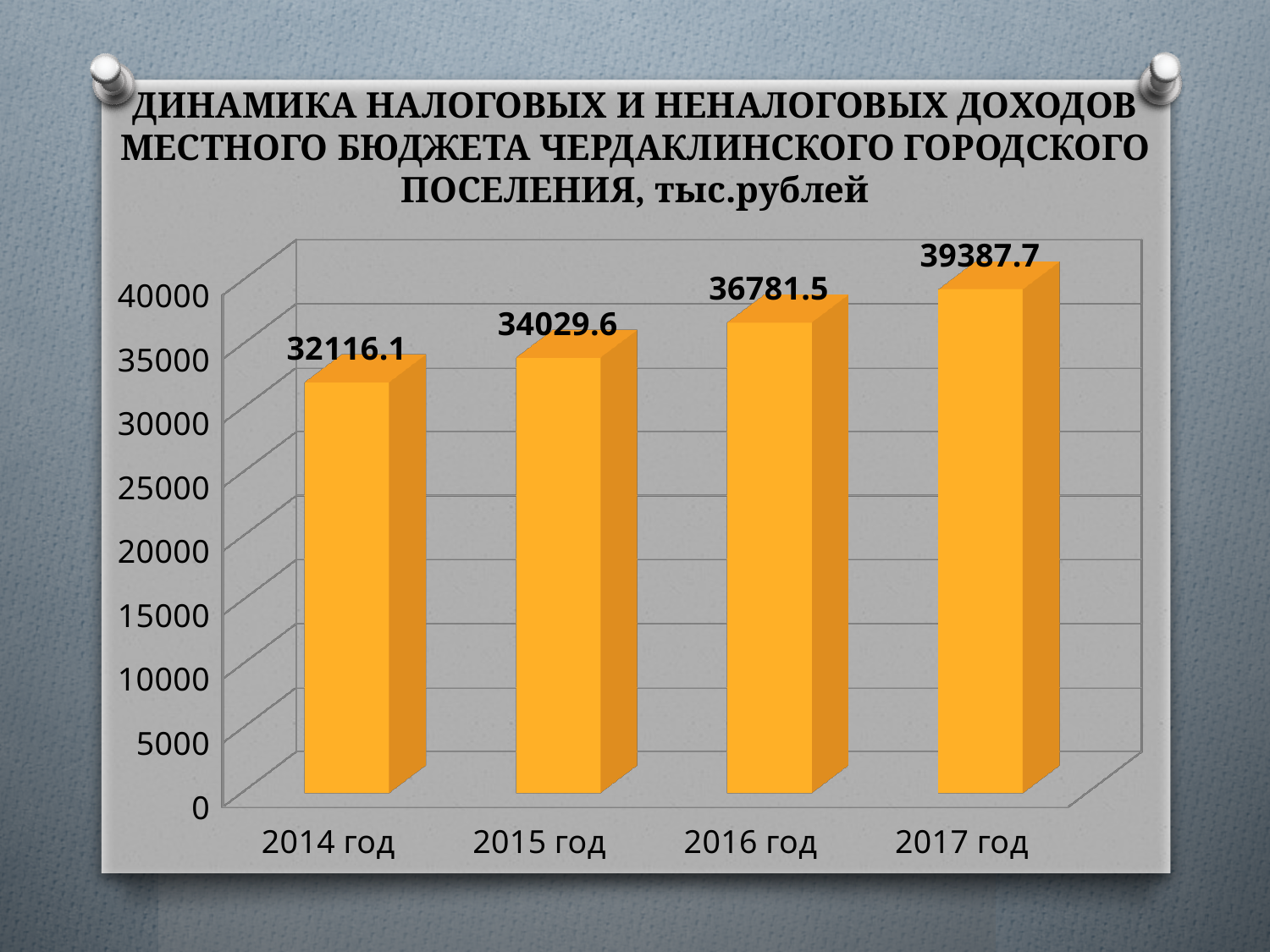
Which is larger, the value for 2015 год or the value for 2016 год? 2016 год What is the value for 2016 год? 36781.5 How many years are shown on the x axis? 4 What is the value for 2017 год? 39387.7 What is the value for 2014 год? 32116.1 Which year has the highest value? 2017 год Is the value for 2017 год greater or less than 40000? less What is the difference between the values for 2017 год and 2014 год? 7271.6 What is the difference between the values for 2016 год and 2015 год? 2751.9 What kind of chart is shown on the slide? bar chart Which year has the lowest value? 2014 год Do the values rise or fall from 2014 год to 2017 год? rise